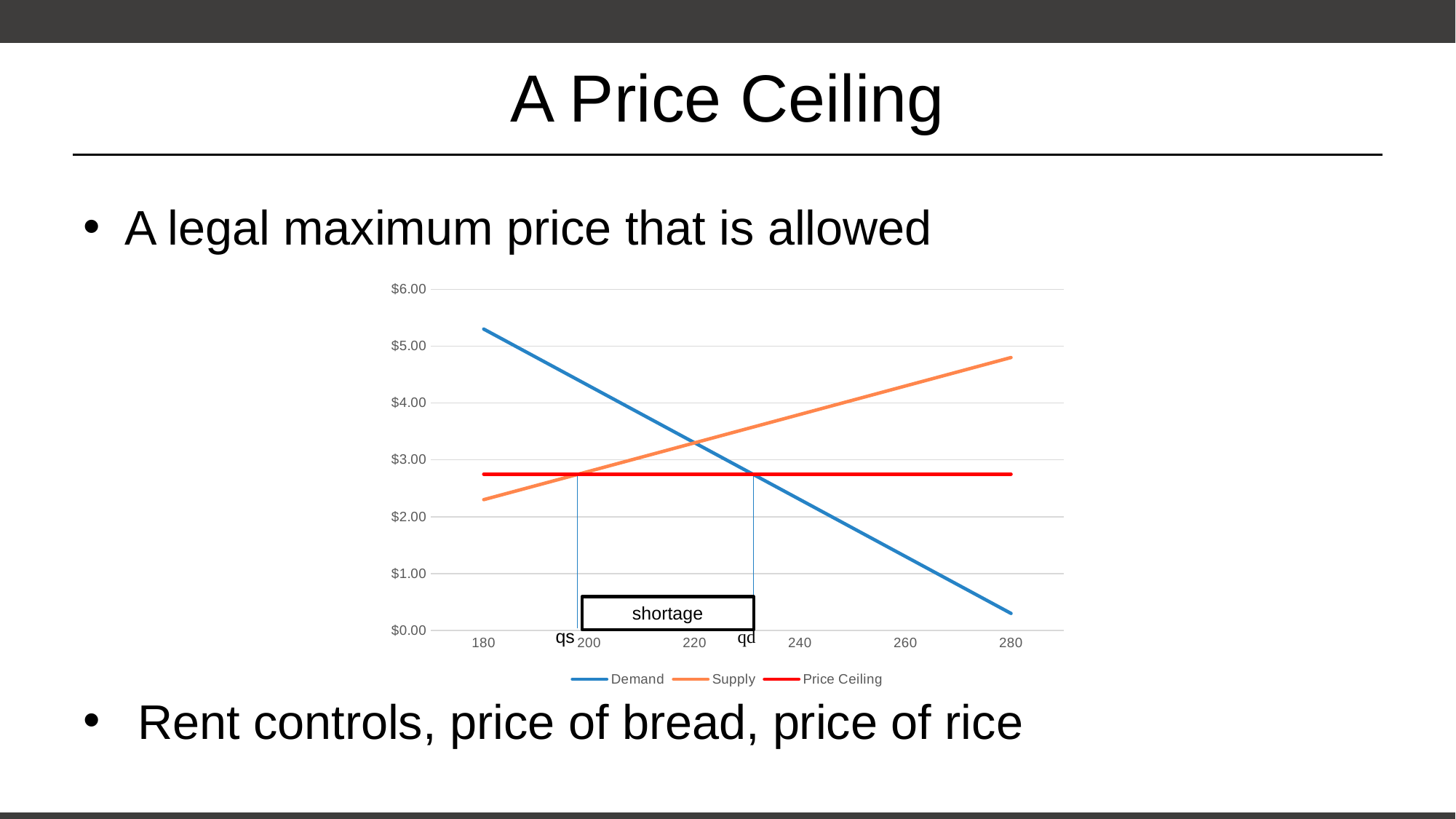
Does the Supply line rise or fall as quantity increases along the x axis? rise Which series are listed in the chart's legend? Demand, Supply, Price Ceiling Is the Supply value at quantity 280 greater or less than $5.00? less Does the Demand line rise or fall as quantity increases along the x axis? fall At quantity 180, which is higher: Demand or Supply? Demand Is the Demand value at quantity 280 greater or less than $1.00? less Is the Price Ceiling level greater or less than $3.00? less How many series does the chart's legend list? 3 What word is written in the box between qs and qd on the chart? shortage At quantity 280, which is higher: Demand or Supply? Supply What kind of chart is shown on the slide? line chart